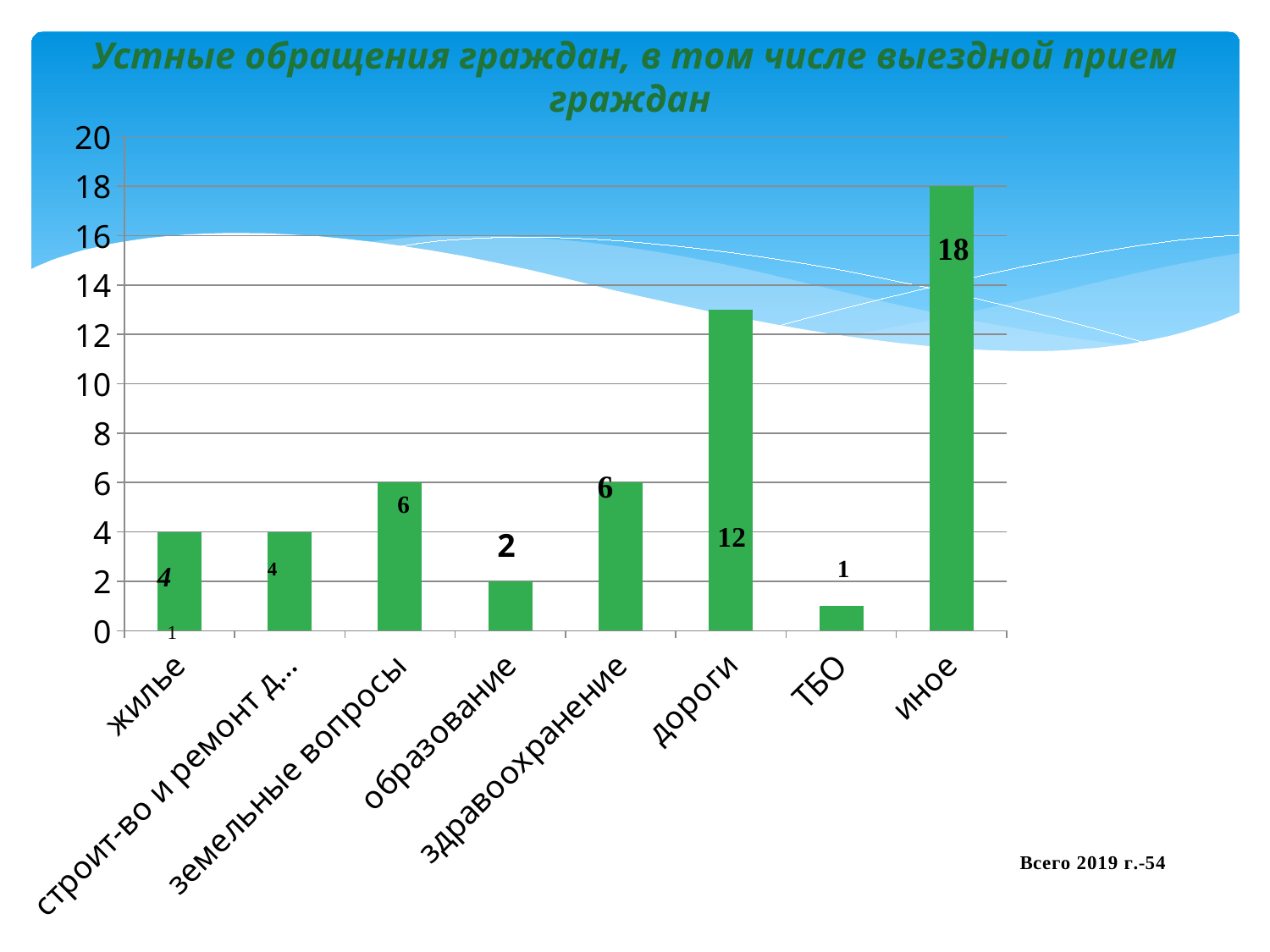
What is the value for "образование"? 2 What kind of chart is shown on the slide? bar chart Which category has the lowest value? ТБО What is the value for "земельные вопросы"? 6 What is the value for "ТБО"? 1 What is the value for "иное"? 18 What is the title of the chart? Устные обращения граждан, в том числе выездной прием граждан How many categories are shown on the x axis? 8 Which category has the highest value? иное Which is larger, the value for "здравоохранение" or the value for "образование"? здравоохранение